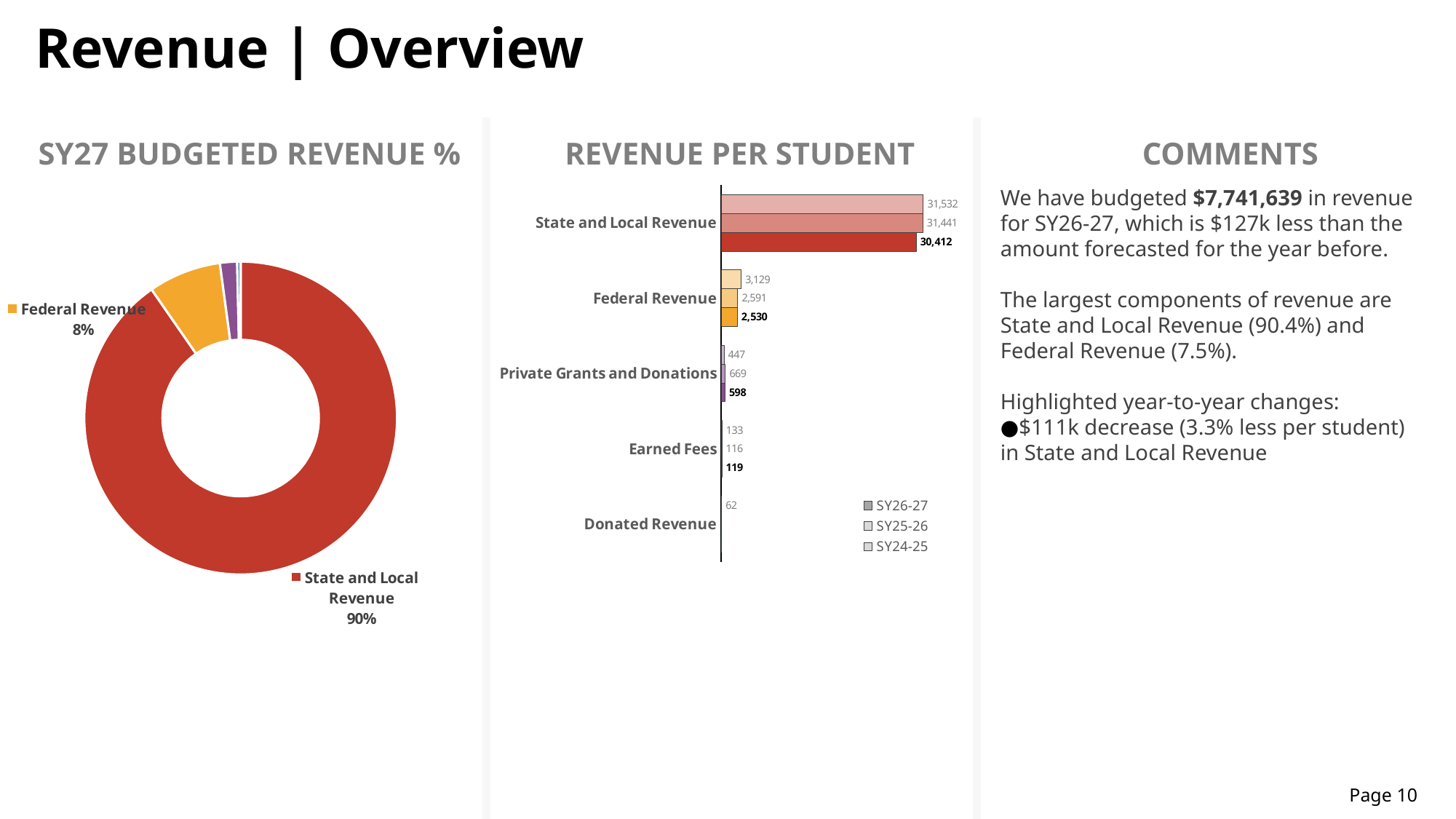
In the REVENUE PER STUDENT chart, what is the SY24-25 value for Federal Revenue? 3,129 In the REVENUE PER STUDENT chart, which is larger for Private Grants and Donations: the SY25-26 value or the SY26-27 value? SY25-26 In the SY27 BUDGETED REVENUE % chart, what share of revenue is State and Local Revenue? 90% In the REVENUE PER STUDENT chart, did Federal Revenue per student rise or fall from SY24-25 to SY26-27? Fall In the REVENUE PER STUDENT chart, which category has the highest revenue per student? State and Local Revenue In the SY27 BUDGETED REVENUE % chart, what share of revenue is Federal Revenue? 8% In the REVENUE PER STUDENT chart, what is the SY26-27 value for State and Local Revenue? 30,412 What kind of chart is the SY27 BUDGETED REVENUE % chart? Pie (donut) chart How many series does the legend of the REVENUE PER STUDENT chart list? 3 In the REVENUE PER STUDENT chart, what is the difference between the SY25-26 and SY26-27 values for State and Local Revenue? 1,029 How many revenue categories are shown in the REVENUE PER STUDENT chart? 5 What kind of chart is the REVENUE PER STUDENT chart? Bar chart